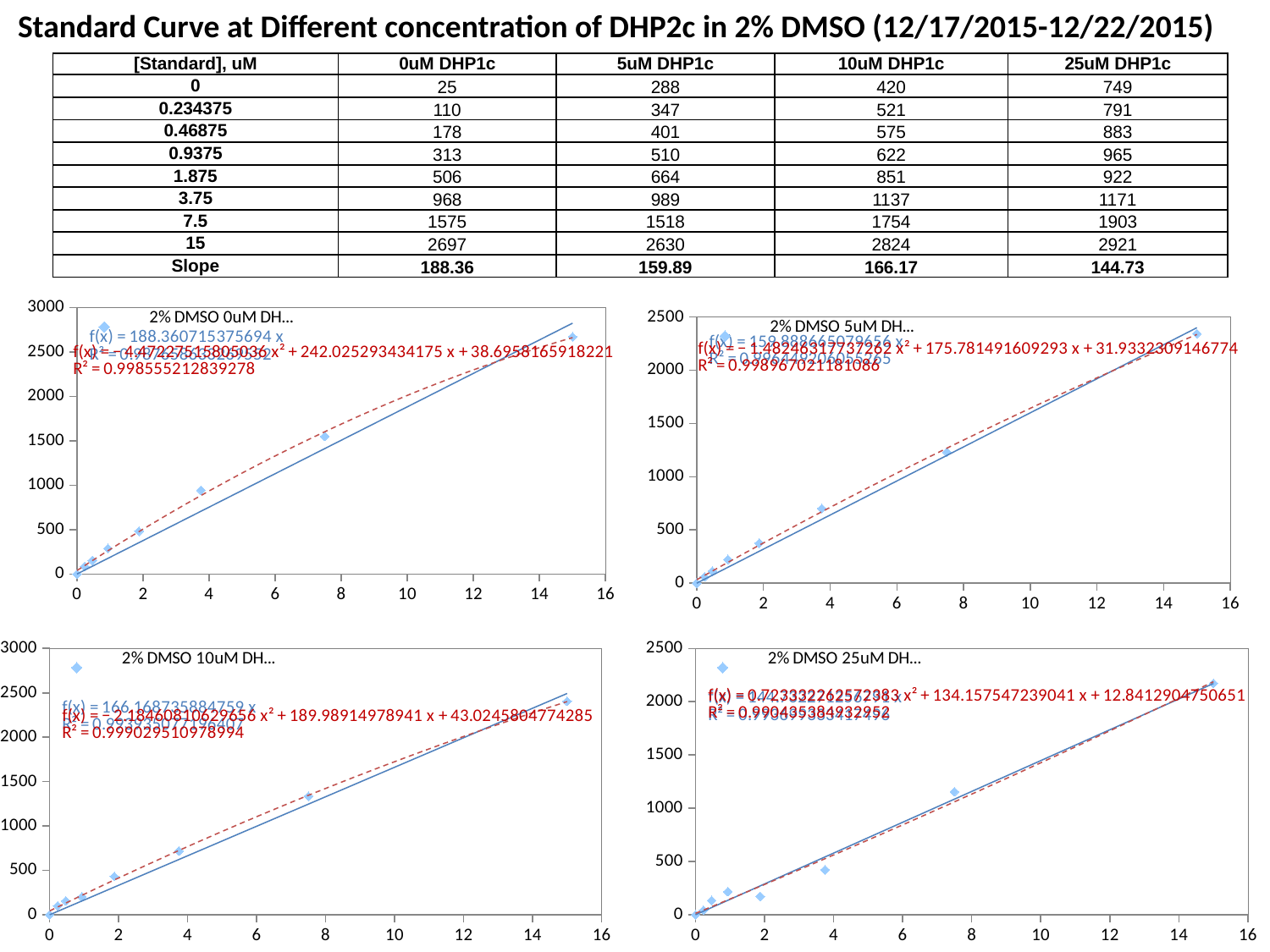
In the top-left chart (2% DMSO 0uM), what is the slope of the linear fit f(x) printed on the chart? 188.3607715375694 In the top-left chart (2% DMSO 0uM), is the value of the point at x = 15 greater or less than 2500? greater In the top-left chart (2% DMSO 0uM), what is the maximum value shown on the y axis? 3000 In the top-right chart (2% DMSO 5uM), is the value of the point at x = 15 greater or less than 2000? greater In the top-left chart (2% DMSO 0uM), do the plotted values rise or fall as the x value increases? rise What kind of chart is the top-left chart titled "2% DMSO 0uM DH..."? scatter chart In the bottom-left chart (2% DMSO 10uM), is the value of the point at x = 3.75 greater or less than 1000? less In the top-right chart (2% DMSO 5uM), which point is larger: the one at x = 7.5 or the one at x = 3.75? x = 7.5 In the bottom-left chart (2% DMSO 10uM), what is the slope of the linear fit f(x) printed on the chart? 166.168735884759 In the bottom-right chart (2% DMSO 25uM), at which x value is the highest plotted point? 15